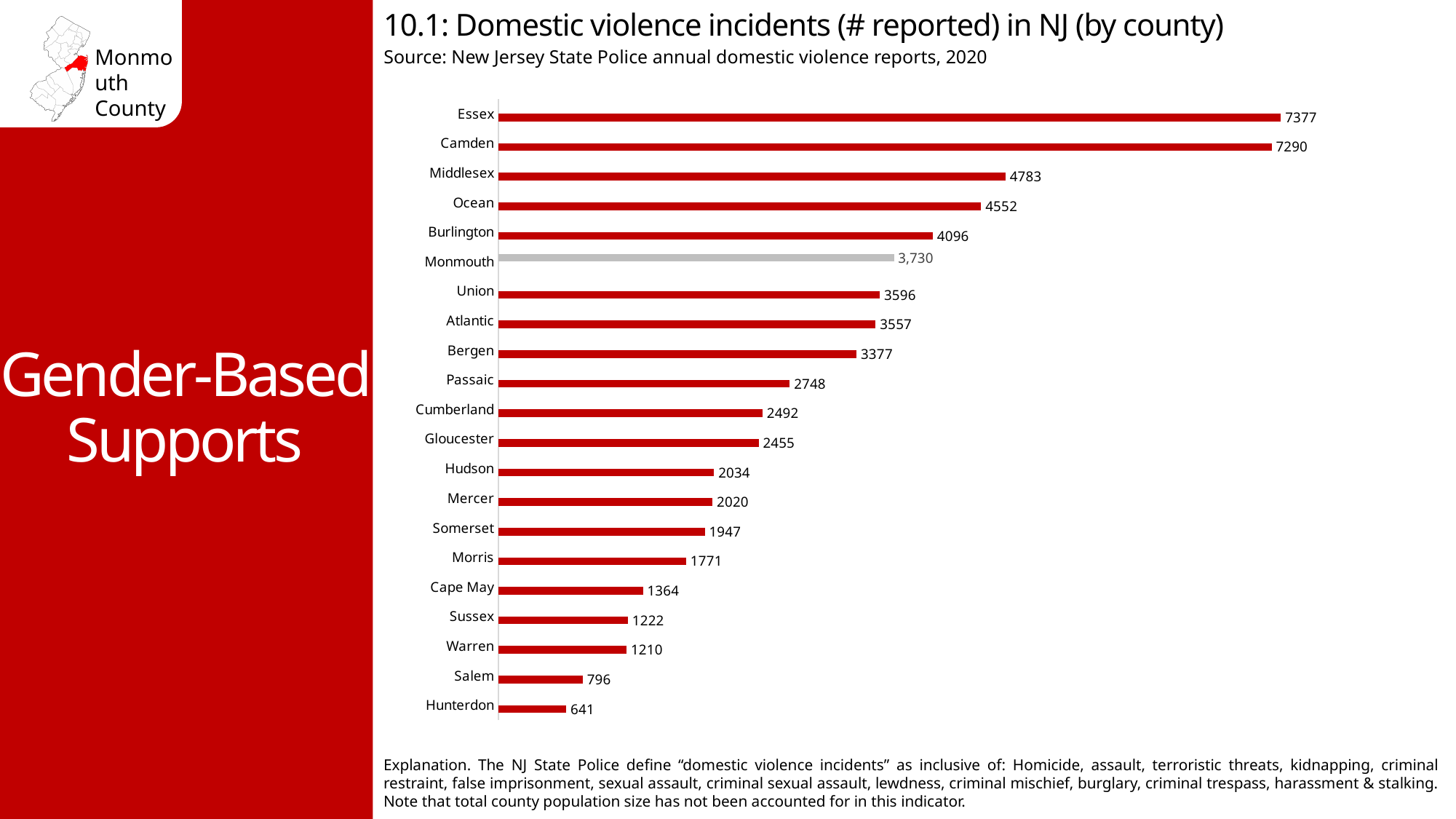
What is the number of reported domestic violence incidents for Hunterdon County? 641 Which county has the highest number of reported domestic violence incidents? Essex What is the difference in reported incidents between Essex and Camden? 87 Which county has more reported incidents, Salem or Warren? Warren What is the number of reported domestic violence incidents for Monmouth County? 3,730 Which county's bar is shown in grey rather than red? Monmouth What is the difference in reported incidents between Middlesex and Ocean? 231 Which county has the lowest number of reported domestic violence incidents? Hunterdon Which county has more reported incidents, Burlington or Union? Burlington What is the number of reported domestic violence incidents for Essex County? 7377 What type of chart is shown on the slide? Bar chart How many counties are shown in the chart? 21